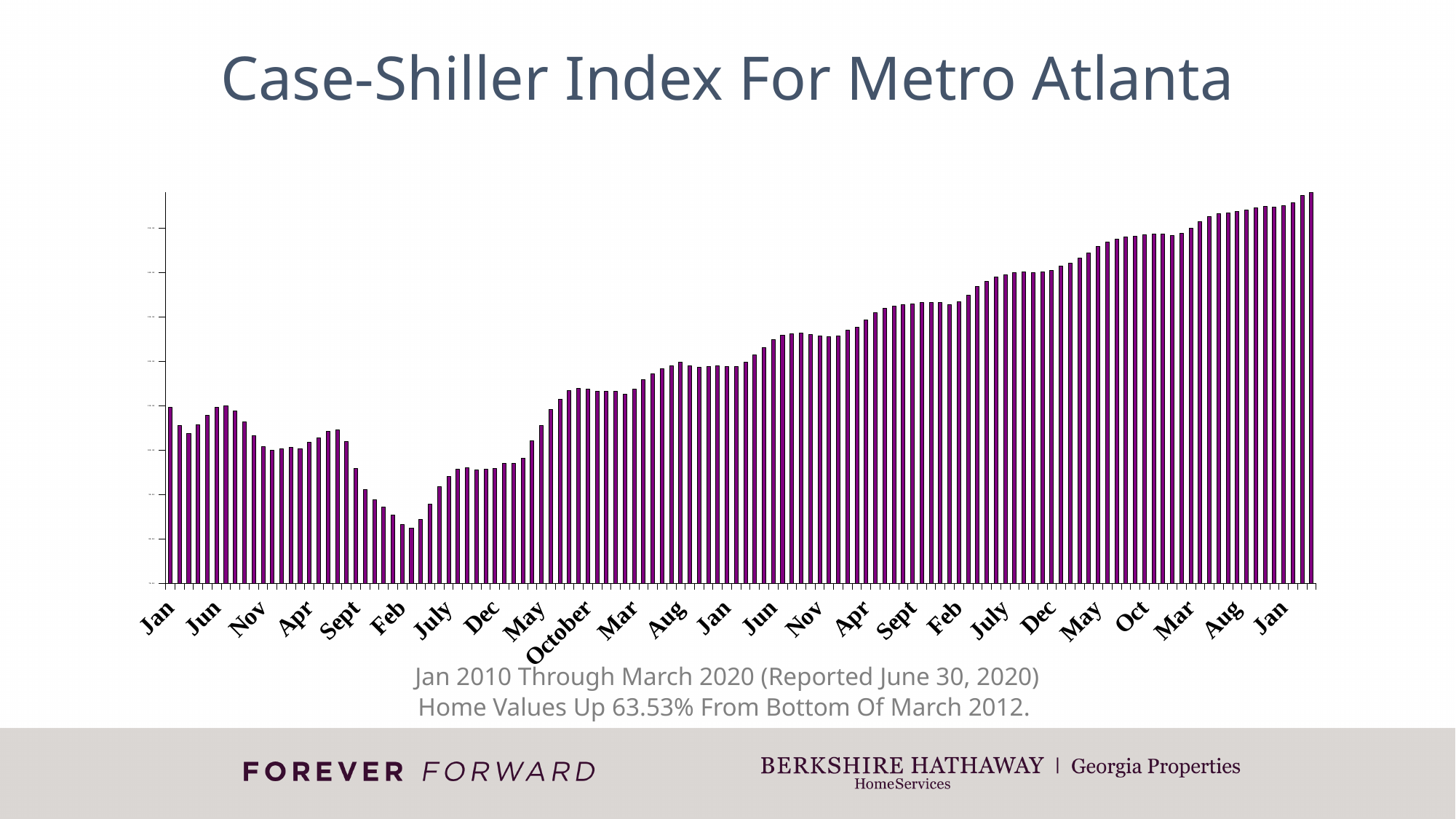
How many data series are plotted in the chart? 1 What is the title of the chart? Case-Shiller Index For Metro Atlanta Which is taller: the first bar at the left ('Jan') or the last bar at the right? the last bar at the right Between the first 'Jan' label and the 'Feb' label, do the bars generally rise or fall? fall Which is taller: the bar at the first 'Jan' label or the bar at the 'Feb' label? the bar at the first 'Jan' label Near which x-axis label are the shortest bars located? Feb According to the caption below the chart, by what percentage are home values up from the bottom of March 2012? 63.53% What kind of chart is shown on the slide? bar chart Which is taller: the bar at the first 'Aug' label or the bar at the first 'Jan' label? the bar at the first 'Aug' label Which bar is the tallest in the chart? the last (rightmost) bar Overall, do the bars rise or fall from the left of the chart to the right? rise From the 'Feb' label to the right end of the chart, do the bars generally rise or fall? rise